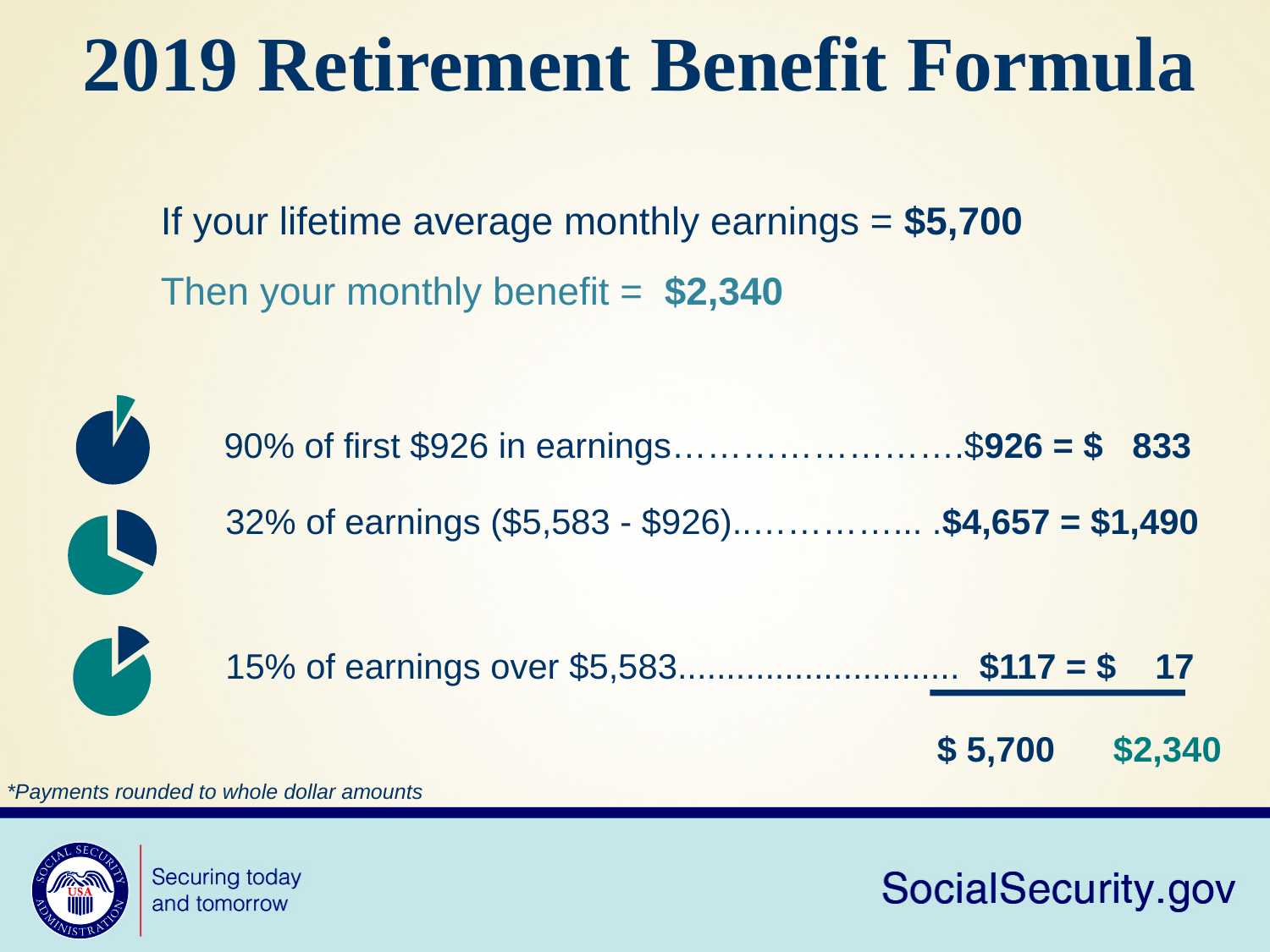
What kind of chart are the small graphics on the left side of the slide? pie chart What benefit amount results from the 32% bracket shown beside the middle pie chart? $1,490 What is the difference between the benefit amounts for the 32% bracket and the 90% bracket? $657 Which of the three brackets shown beside the pie charts produces the largest benefit amount? 32% of earnings ($5,583 - $926) What benefit amount results from the 15% bracket shown beside the bottom pie chart? $17 Which of the three brackets shown beside the pie charts produces the smallest benefit amount? 15% of earnings over $5,583 What dollar amount of earnings is shown next to the top pie chart (90% of first $926)? $926 What is the total monthly benefit shown at the bottom of the three pie chart rows? $2,340 How many pie chart icons are shown on the slide? 3 In the bottom pie chart, which colour fills most of the pie? teal In the top pie chart, which colour fills most of the pie? dark blue What benefit amount results from the 90% bracket shown beside the top pie chart? $833